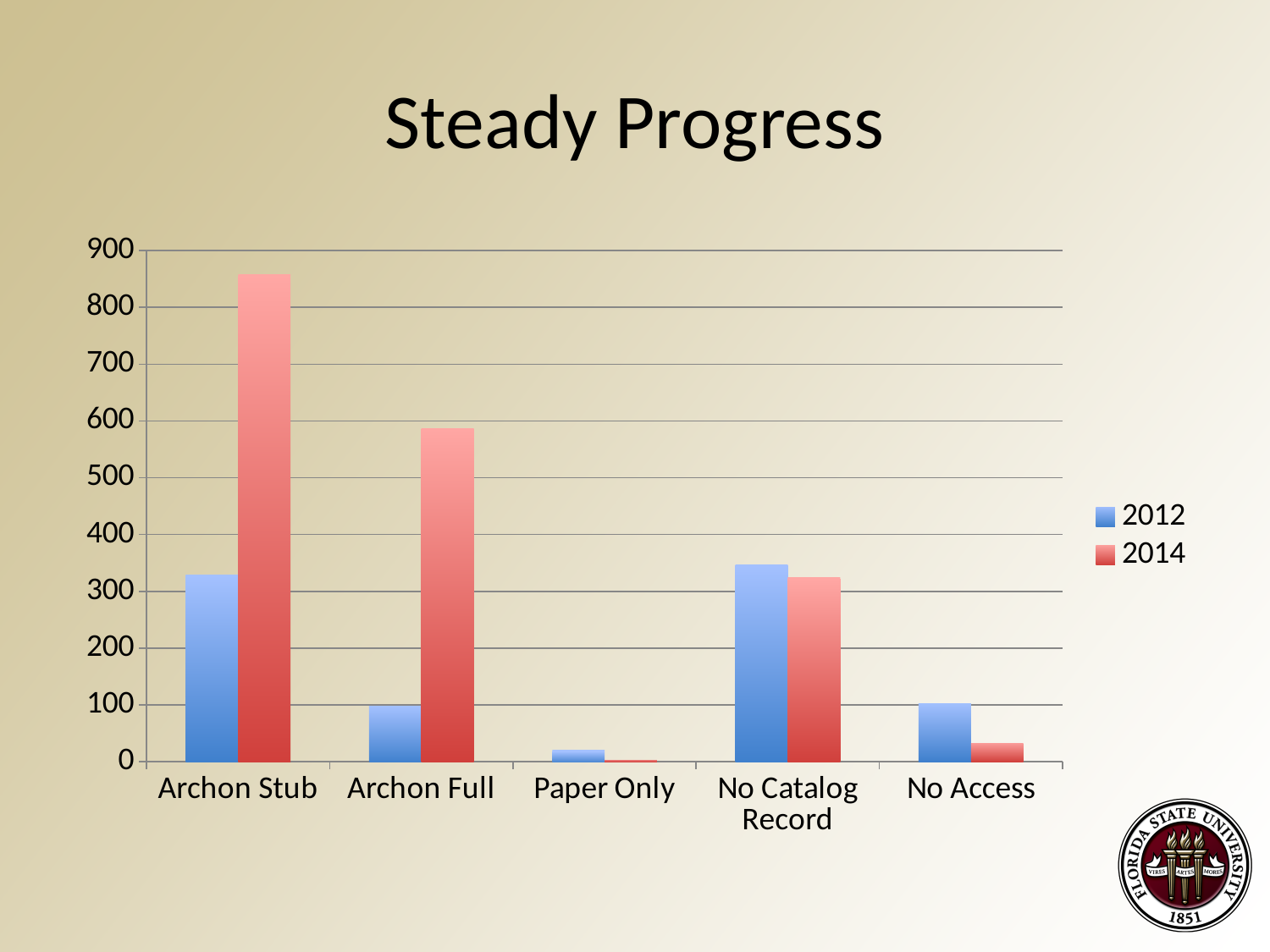
What kind of chart is shown on the slide? bar chart Is the 2014 value for Archon Full greater or less than 500? greater Is the 2012 value for Archon Stub greater or less than 400? less Which category has the lowest 2012 value? Paper Only Which category has the lowest 2014 value? Paper Only What is the title of the chart? Steady Progress For Archon Full, which series has the larger value, 2012 or 2014? 2014 How many series does the legend list? 2 Which category has the highest 2014 value? Archon Stub How many categories are shown on the x axis? 5 Which category has the highest 2012 value? No Catalog Record Is the 2014 value for Archon Stub greater or less than 800? greater